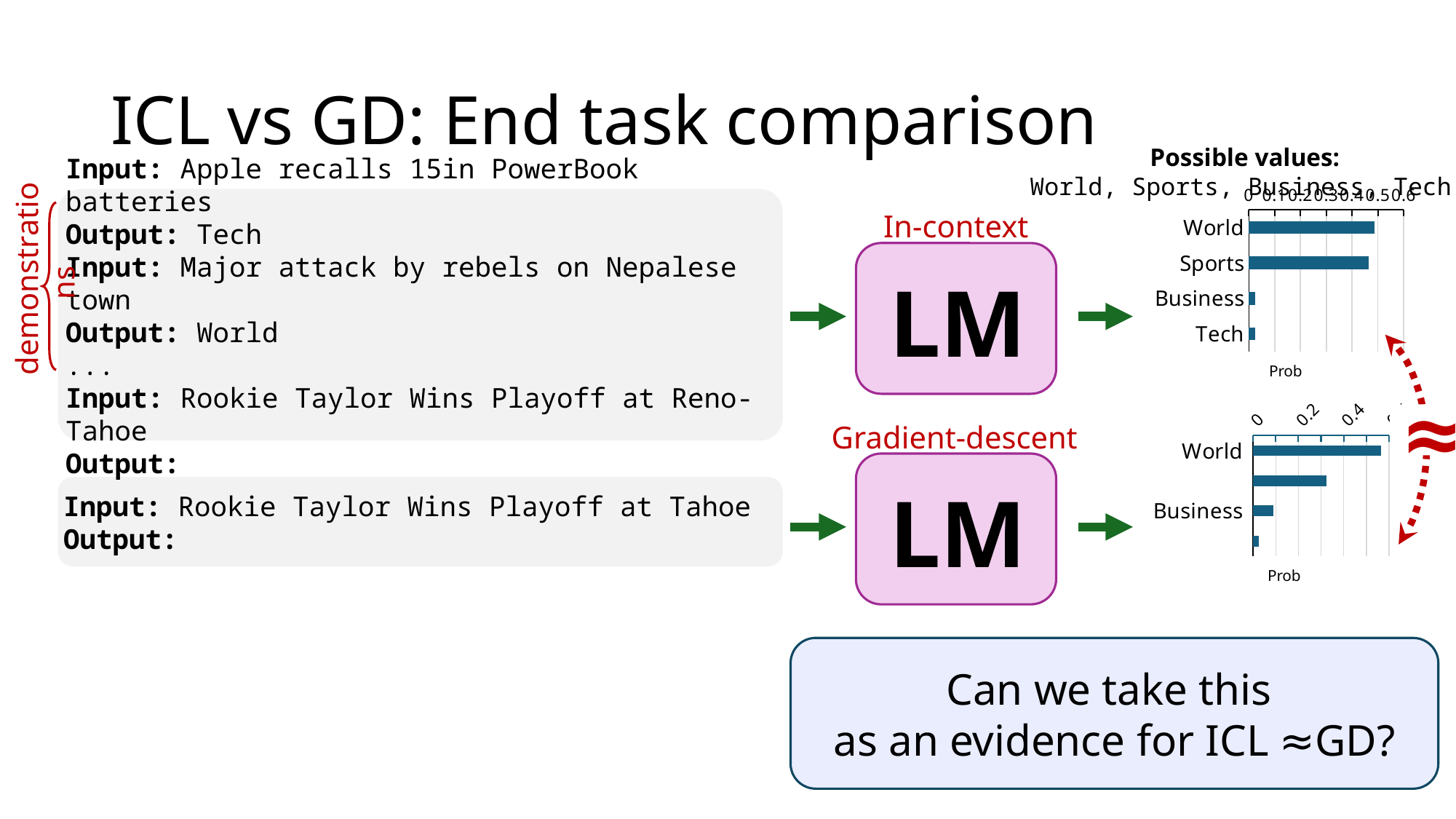
What kind of chart is the In-context chart on the right of the slide? bar chart In the Gradient-descent chart, is the value for World greater or less than 0.4? greater How many categories does the In-context chart show? 4 What is the x-axis label of the In-context chart? Prob In the In-context chart, which is larger, the value for Sports or the value for Business? Sports In the In-context chart, is the value for Business greater or less than 0.1? less In the Gradient-descent chart, is the value for Business greater or less than 0.2? less In the Gradient-descent chart, which is larger, the value for World or the value for Business? World How many bars does the Gradient-descent chart show? 4 In the In-context chart, which is larger, the value for World or the value for Tech? World In the Gradient-descent chart, which category has the highest value? World